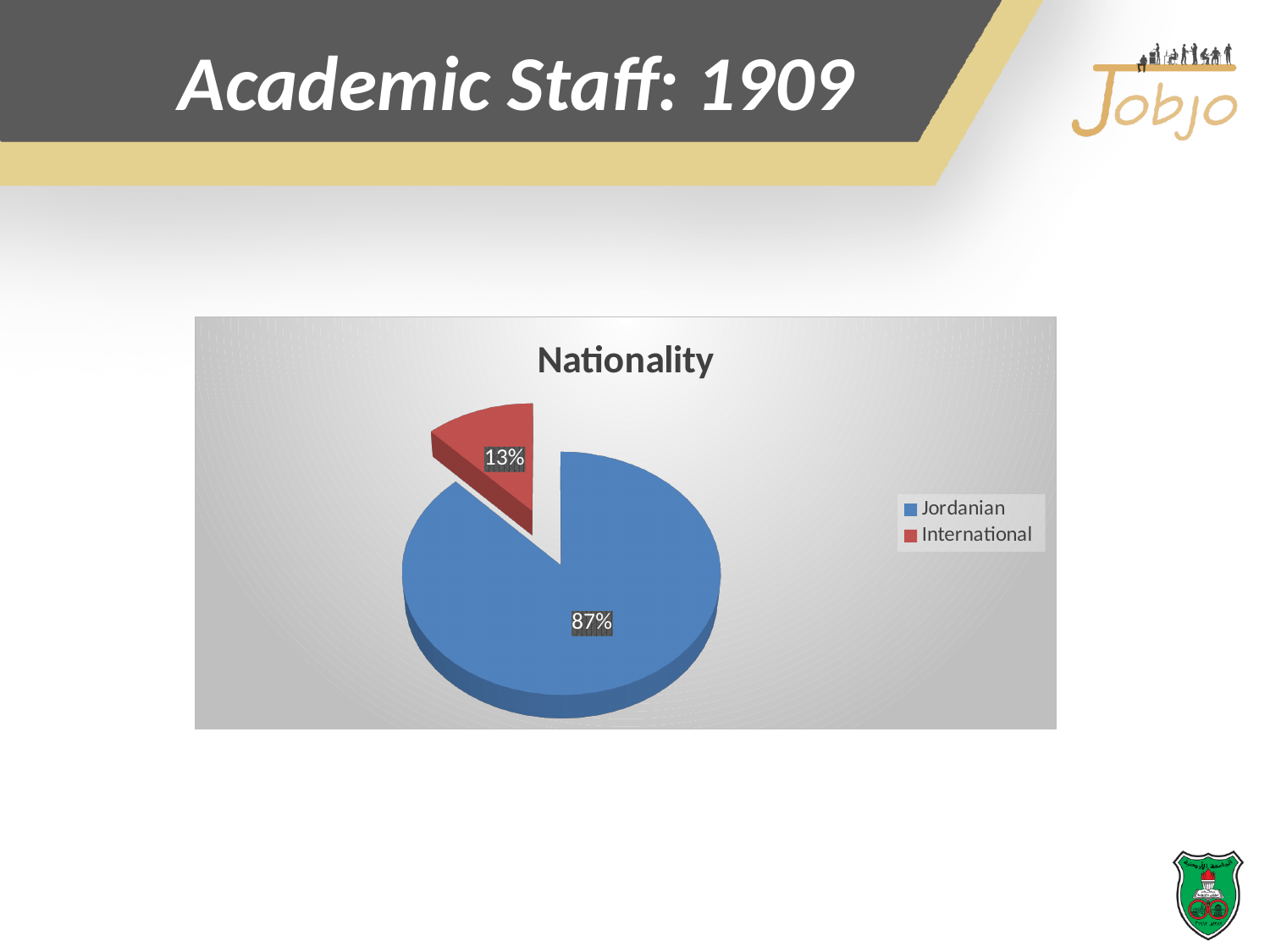
Which category has the smallest slice of the pie? International What is the title of the chart? Nationality What share of the pie is Jordanian? 87% How many entries does the legend list? 2 What colour is the International slice? Red What share of the pie is International? 13% Which is larger, the Jordanian slice or the International slice? Jordanian What is the difference in percentage points between the Jordanian and International slices? 74 What type of chart is shown on the slide? Pie chart Which category has the largest slice of the pie? Jordanian How many categories does the pie chart show? 2